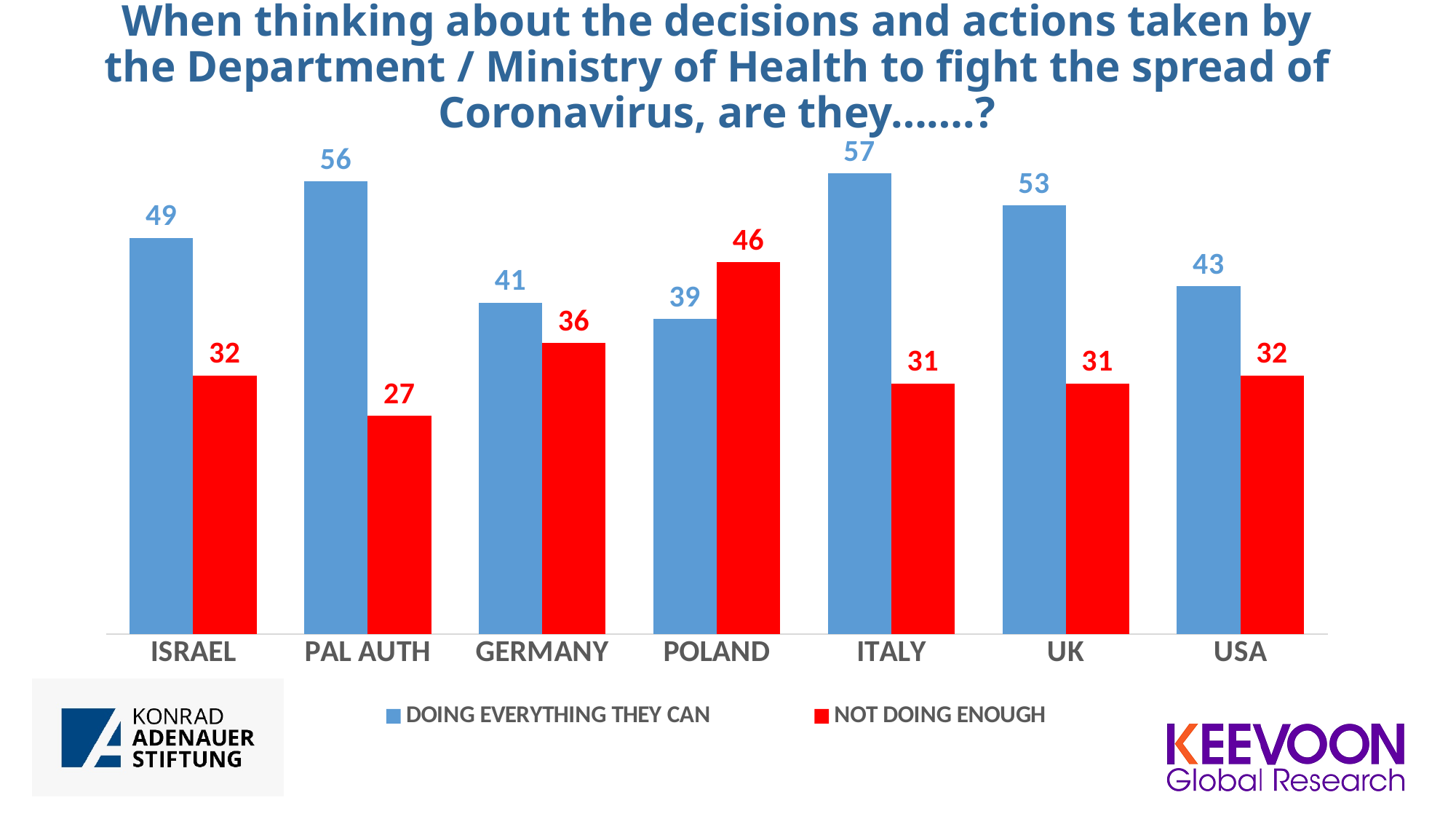
What is the value for "NOT DOING ENOUGH" for POLAND? 46 What is the value for "NOT DOING ENOUGH" for PAL AUTH? 27 How many series does the legend list? 2 What colour are the "NOT DOING ENOUGH" bars? Red What kind of chart is shown on the slide? Bar chart What is the value for "DOING EVERYTHING THEY CAN" for ITALY? 57 Which is larger for POLAND: "DOING EVERYTHING THEY CAN" or "NOT DOING ENOUGH"? NOT DOING ENOUGH How many countries are shown on the x axis? 7 Which country has a higher "DOING EVERYTHING THEY CAN" value, UK or USA? UK What is the difference between the "DOING EVERYTHING THEY CAN" and "NOT DOING ENOUGH" values for ISRAEL? 17 Which country has the highest value for "DOING EVERYTHING THEY CAN"? ITALY Which country has the lowest value for "NOT DOING ENOUGH"? PAL AUTH